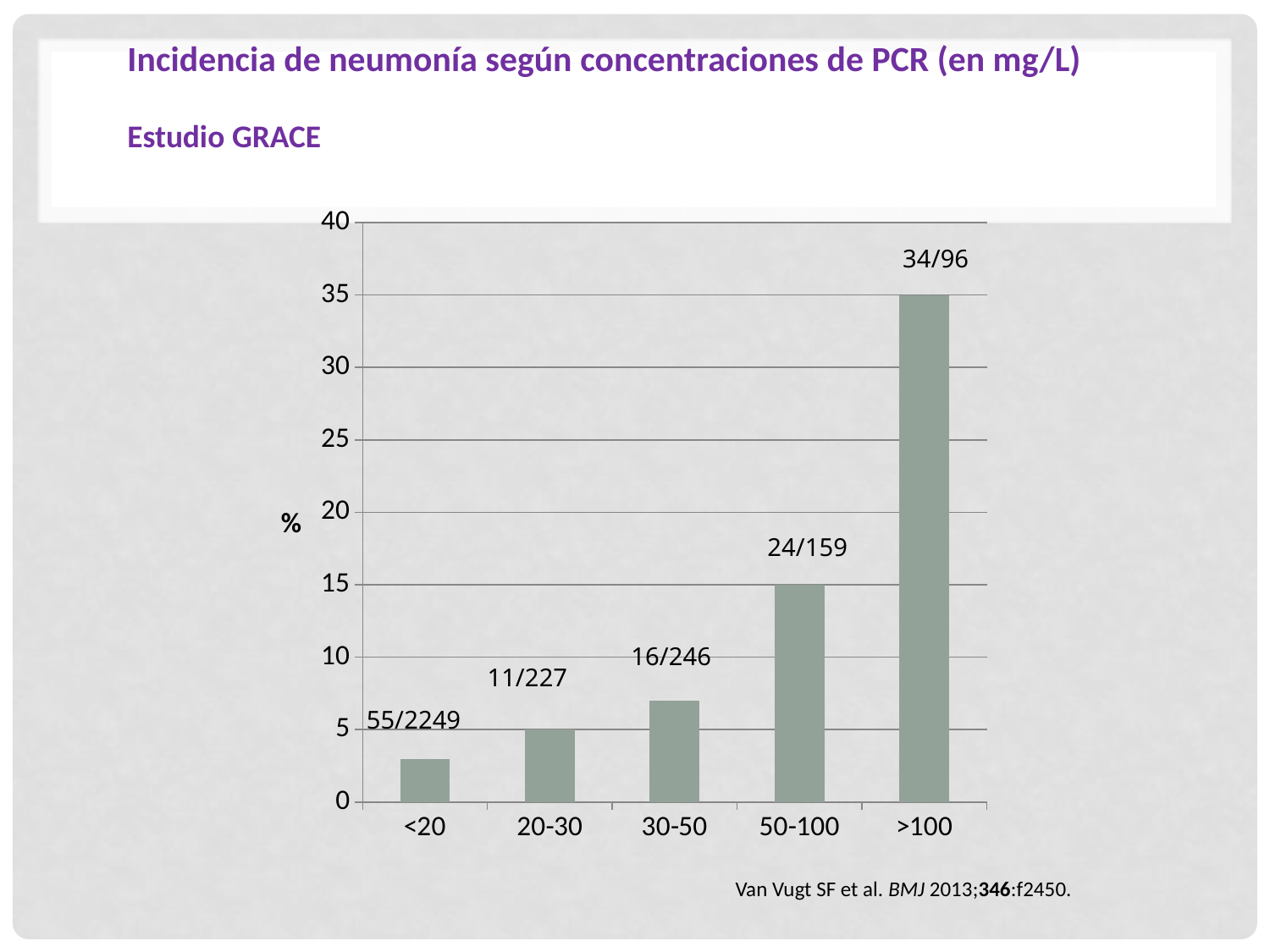
Is the value for the <20 category greater or less than 5? less What data label is printed above the bar for the 50-100 category? 24/159 Which PCR concentration category has the lowest incidence of pneumonia? <20 Do the bar values rise or fall as PCR concentration increases along the x axis? rise What data label is printed above the bar for the 30-50 category? 16/246 What kind of chart is shown on the slide? bar chart What data label is printed above the bar for the <20 category? 55/2249 How many PCR concentration categories are shown on the x axis? 5 Which category has a higher incidence, 30-50 or 50-100? 50-100 Is the value for the >100 category greater or less than 30? greater What data label is printed above the bar for the >100 category? 34/96 Which PCR concentration category has the highest incidence of pneumonia? >100